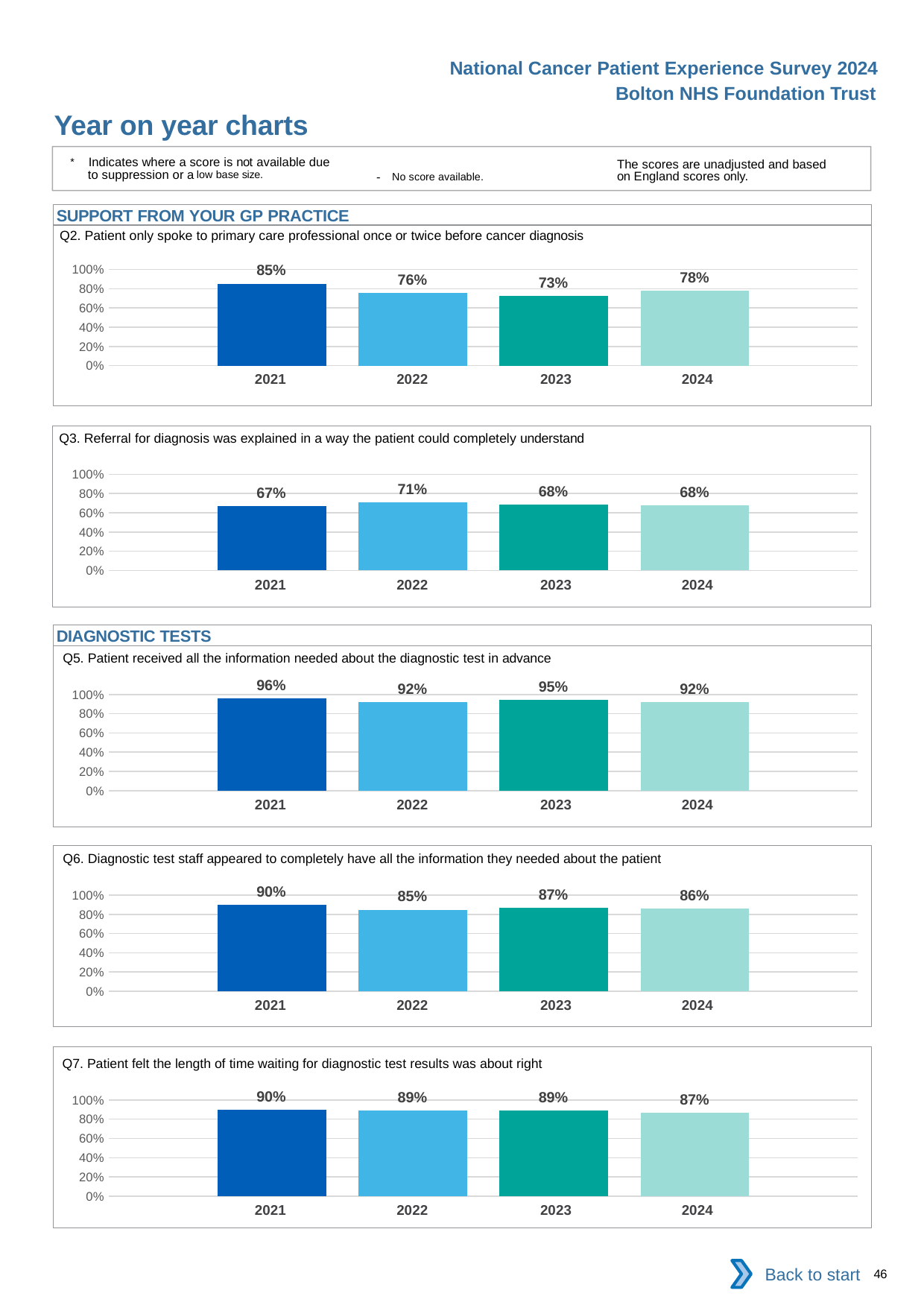
In the Q7 chart (patient felt the length of time waiting for diagnostic test results was about right), what is the difference between the 2021 value and the 2024 value? 3 percentage points In the Q3 chart, what is the difference between the 2022 value and the 2021 value? 4 percentage points In the Q2 chart (patient only spoke to primary care professional once or twice before cancer diagnosis), what is the value for 2021? 85% How many years are shown on the x axis of the Q7 chart? 4 In the Q5 chart (patient received all the information needed about the diagnostic test in advance), what is the value for 2023? 95% In the Q5 chart, is the value for 2021 greater or less than 80%? greater What kind of chart is the Q2 chart? Bar chart In the Q3 chart (referral for diagnosis was explained in a way the patient could completely understand), which year has the highest value? 2022 In the Q2 chart, which year has the lowest value? 2023 Which section heading appears above the Q5 chart? DIAGNOSTIC TESTS In the Q6 chart, what is the value for 2024? 86% In the Q6 chart (diagnostic test staff appeared to completely have all the information they needed about the patient), which is larger, the 2021 value or the 2022 value? 2021